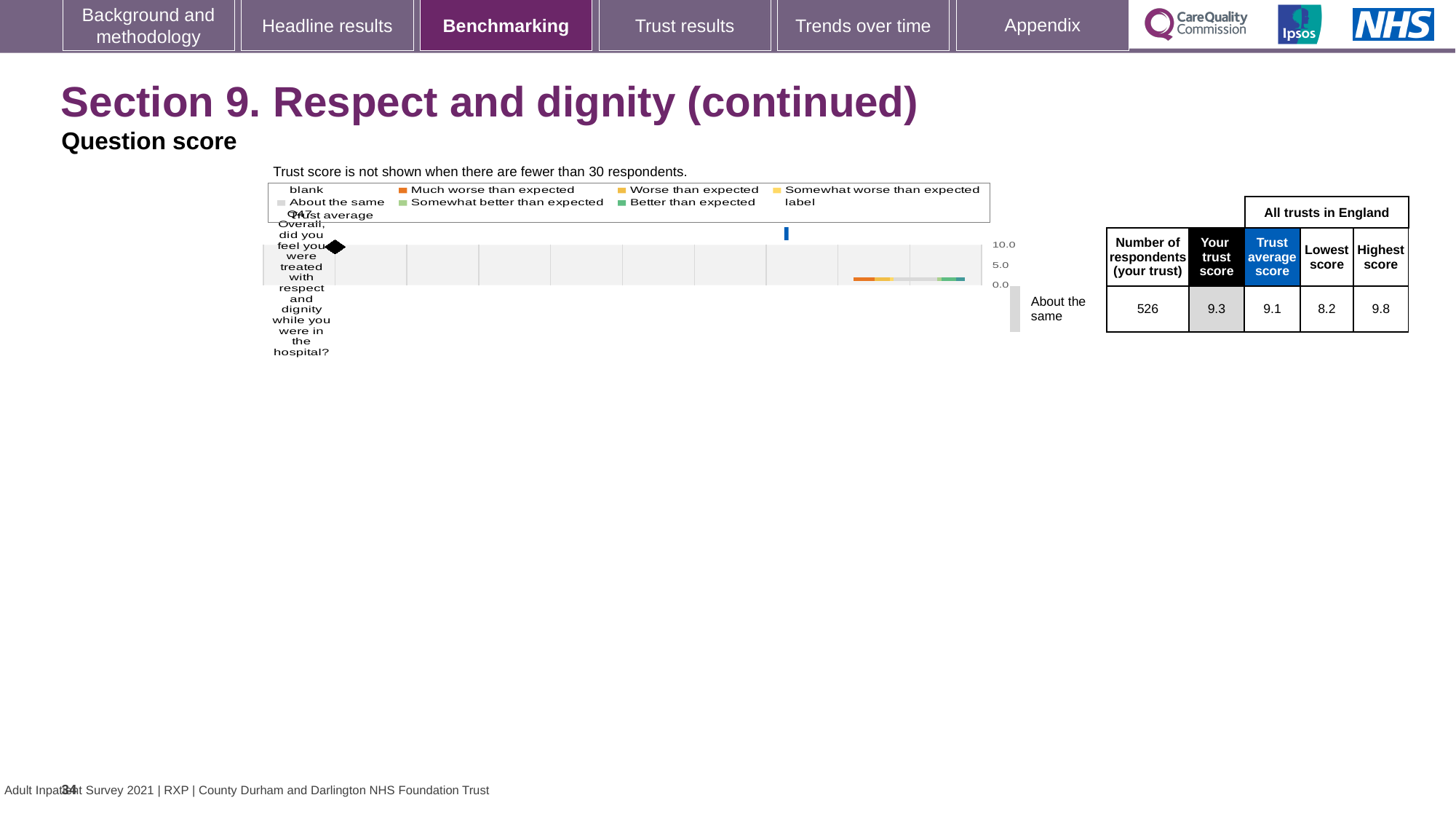
In the table beside the chart, what is the number of respondents for your trust? 526 What is the difference between your trust score and the trust average score? 0.2 Which is larger, your trust score or the trust average score? your trust score Which question number is plotted on the chart? Q47 What kind of chart is shown on the slide? bar chart In the table beside the chart, what is the trust average score for all trusts in England? 9.1 What benchmark category label is shown next to the chart for this question? About the same In the table beside the chart, what is your trust score for Q47? 9.3 What is the difference between the highest score and the lowest score among all trusts in England? 1.6 In the table beside the chart, what is the lowest score among all trusts in England? 8.2 What is the highest tick value shown on the chart's vertical axis? 10.0 In the table beside the chart, what is the highest score among all trusts in England? 9.8